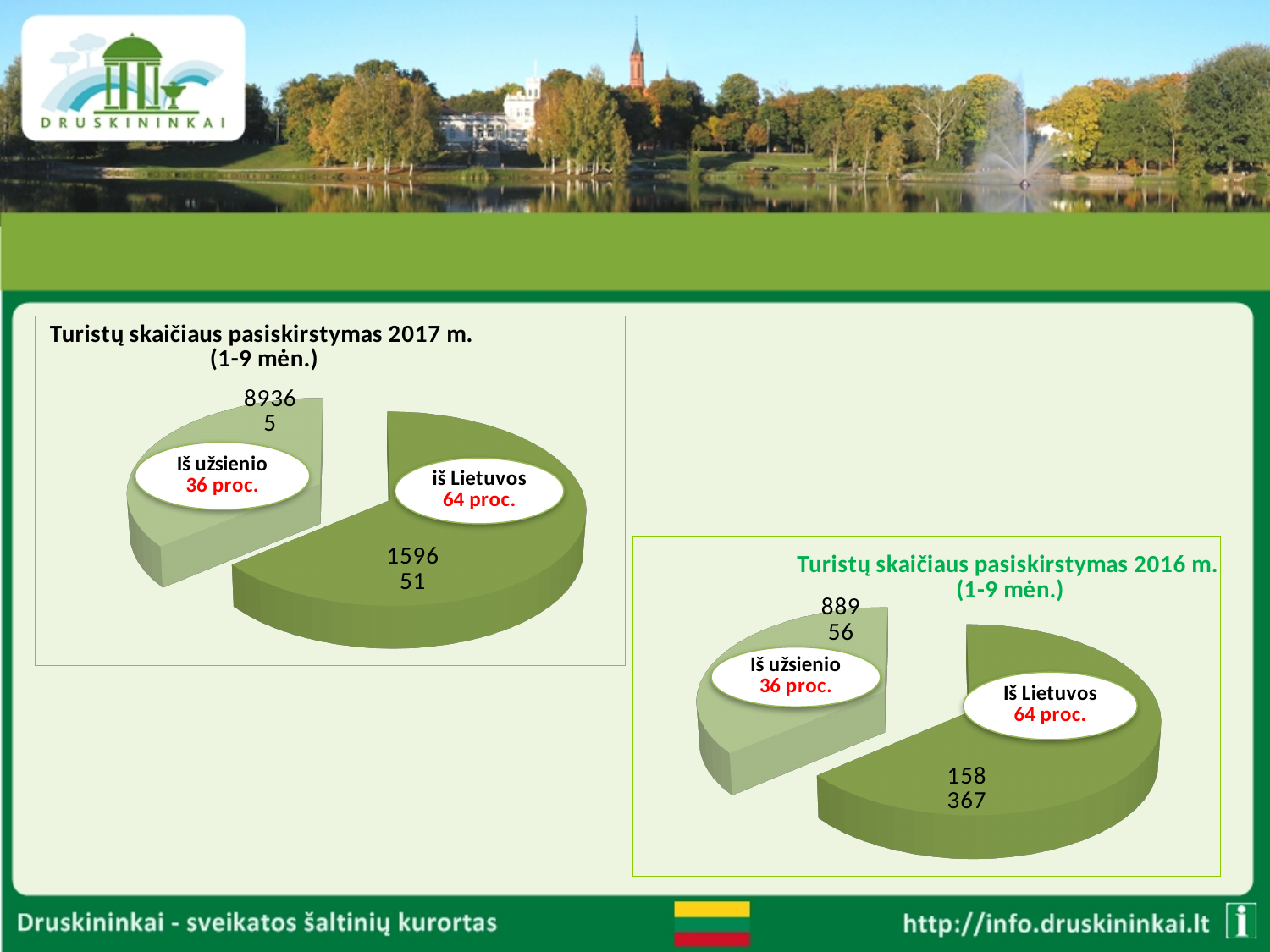
What kind of chart is the left chart titled "Turistų skaičiaus pasiskirstymas 2017 m. (1-9 mėn.)"? pie chart What is the title of the chart on the left of the slide? Turistų skaičiaus pasiskirstymas 2017 m. (1-9 mėn.) In the 2017 chart (left), what share of tourists is labelled for "iš Lietuvos"? 64 proc. How many slices does the 2016 chart (right) have? 2 What kind of chart is the right chart titled "Turistų skaičiaus pasiskirstymas 2016 m. (1-9 mėn.)"? pie chart In the 2016 chart (right), what is the difference in percentage points between the "Iš Lietuvos" share and the "Iš užsienio" share? 28 In the 2017 chart (left), which slice is the largest? iš Lietuvos In the 2016 chart (right), which slice is the smallest? Iš užsienio In the 2016 chart (right), what share of tourists is labelled for "Iš užsienio"? 36 proc. In the 2017 chart (left), what share of tourists is labelled for "Iš užsienio"? 36 proc. In the 2017 chart (left), which is larger: the share for "iš Lietuvos" or the share for "Iš užsienio"? iš Lietuvos